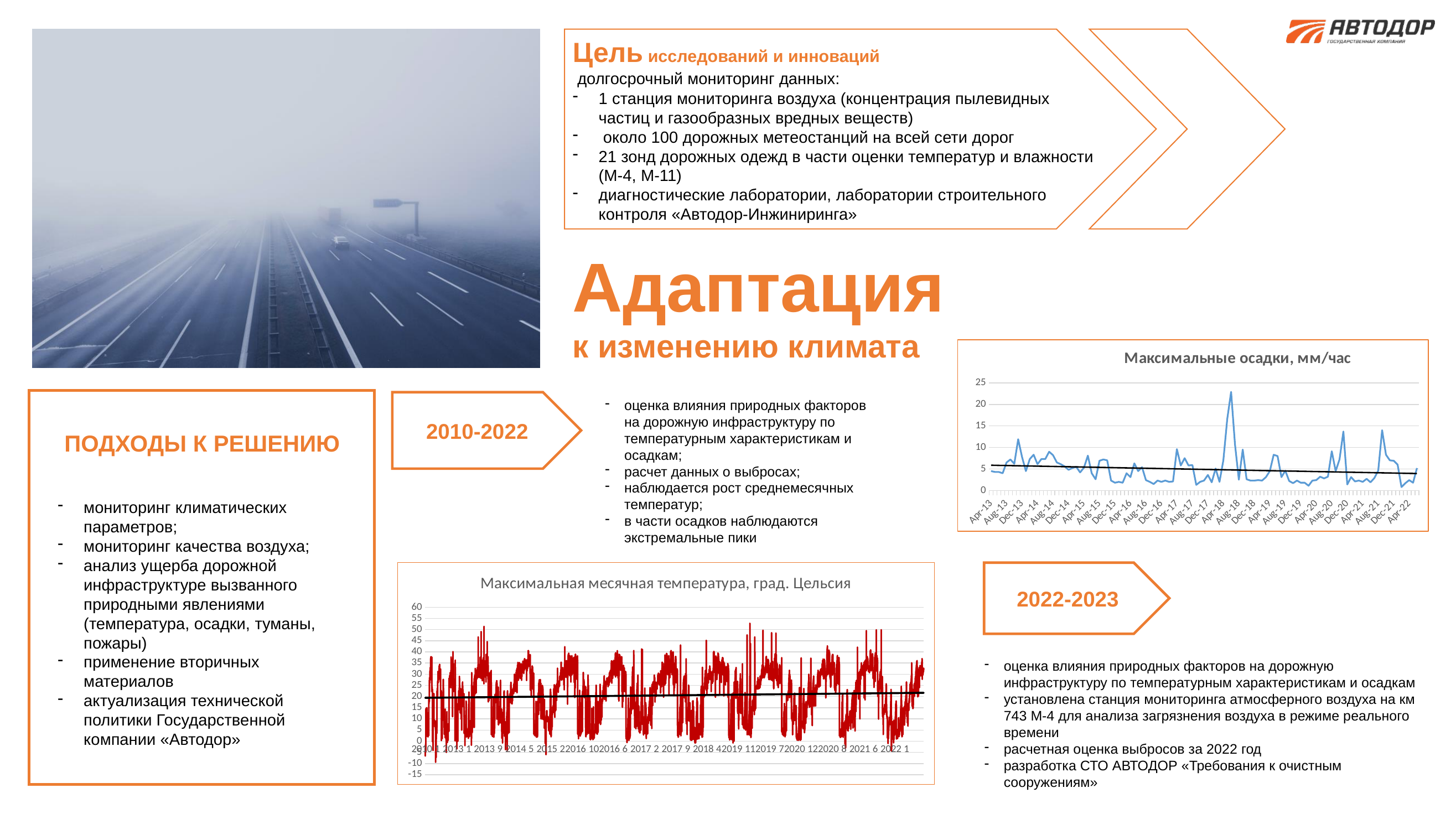
What is the title of the chart at the bottom centre of the slide? Максимальная месячная температура, град. Цельсия In the chart "Максимальные осадки, мм/час", is the value at Apr-13 greater or less than 10? less What kind of chart is the chart titled "Максимальная месячная температура, град. Цельсия"? line chart In the chart "Максимальная месячная температура, град. Цельсия", is the highest value of the red line greater or less than 50? greater In the chart "Максимальная месячная температура, град. Цельсия", is the lowest value of the red line greater or less than 0? less What kind of chart is the chart titled "Максимальные осадки, мм/час"? line chart What is the title of the chart in the upper right of the slide? Максимальные осадки, мм/час In the chart "Максимальные осадки, мм/час", does the black trend line rise or fall from left to right? falls In the chart "Максимальная месячная температура, град. Цельсия", does the black trend line rise or fall from left to right? rises